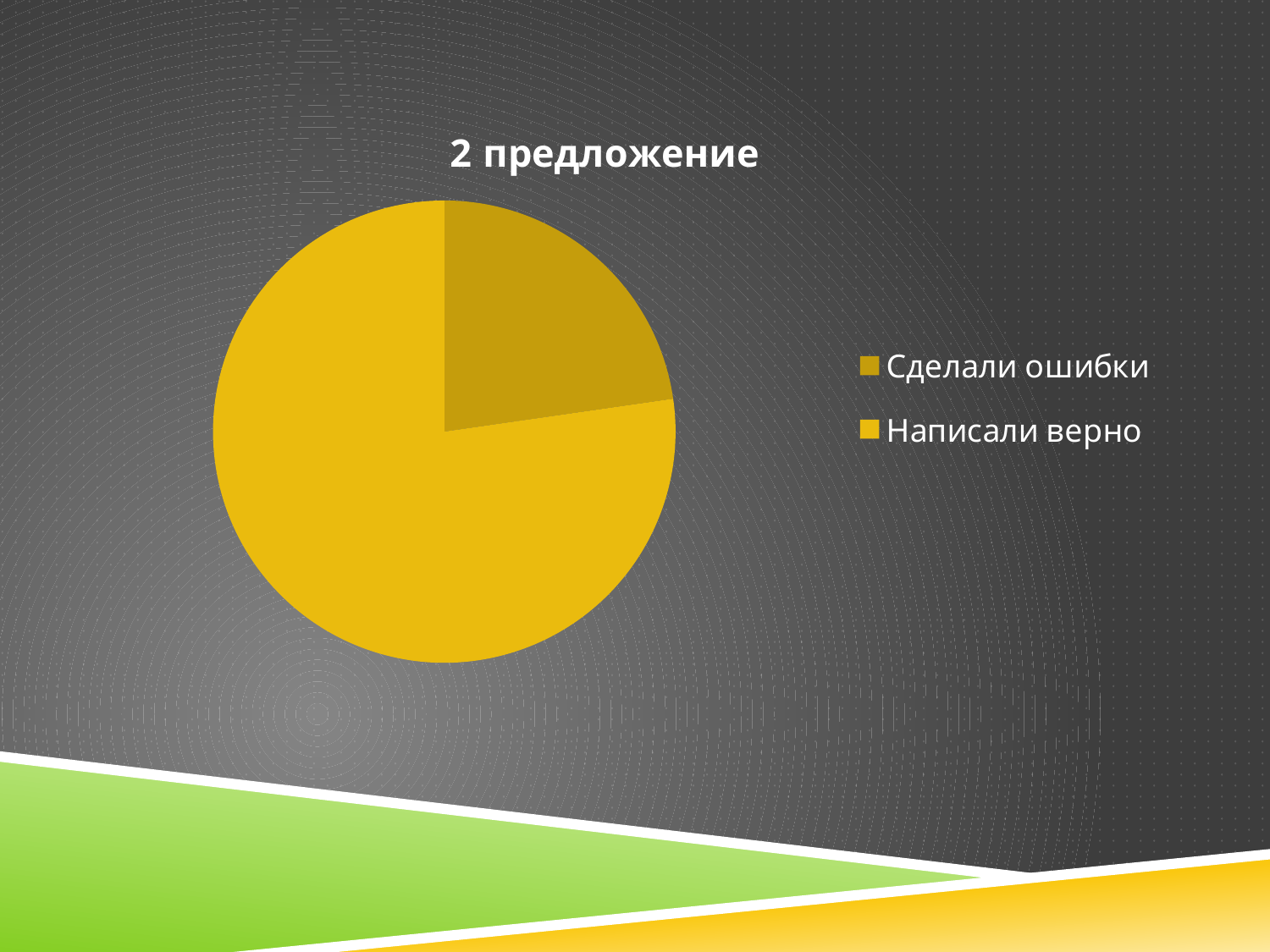
Which category has the smallest slice of the pie? Сделали ошибки How many entries does the legend list? 2 How many slices does the pie chart have? 2 What are the two legend entries of the chart? Сделали ошибки, Написали верно Which category has the largest slice of the pie? Написали верно Which is larger: the slice for Сделали ошибки or the slice for Написали верно? Написали верно What kind of chart is shown on the slide? pie chart What is the title of the chart? 2 предложение